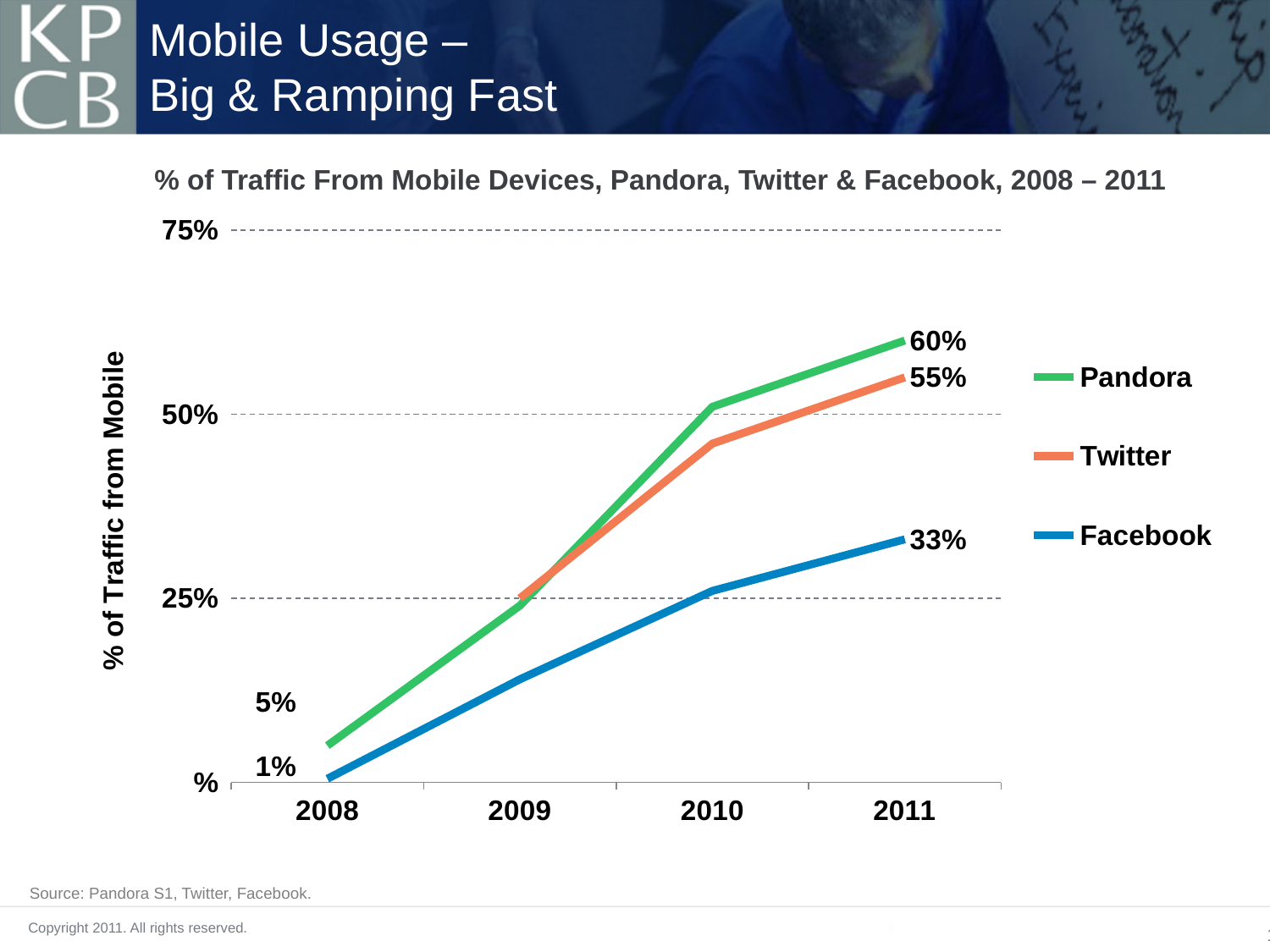
What is the difference between Pandora's and Facebook's values in 2011? 27% How many series does the legend list? 3 What is the value for Facebook in 2008? 1% What is the value for Pandora in 2011? 60% Does the Facebook line rise or fall from 2008 to 2011? rise Which series has the highest value in 2011? Pandora Which series has the lowest value in 2011? Facebook Is the value for Twitter in 2010 greater or less than 50%? less What is the value for Twitter in 2011? 55% What type of chart is shown on the slide? line chart What is the value for Facebook in 2011? 33% What is the value for Pandora in 2008? 5%